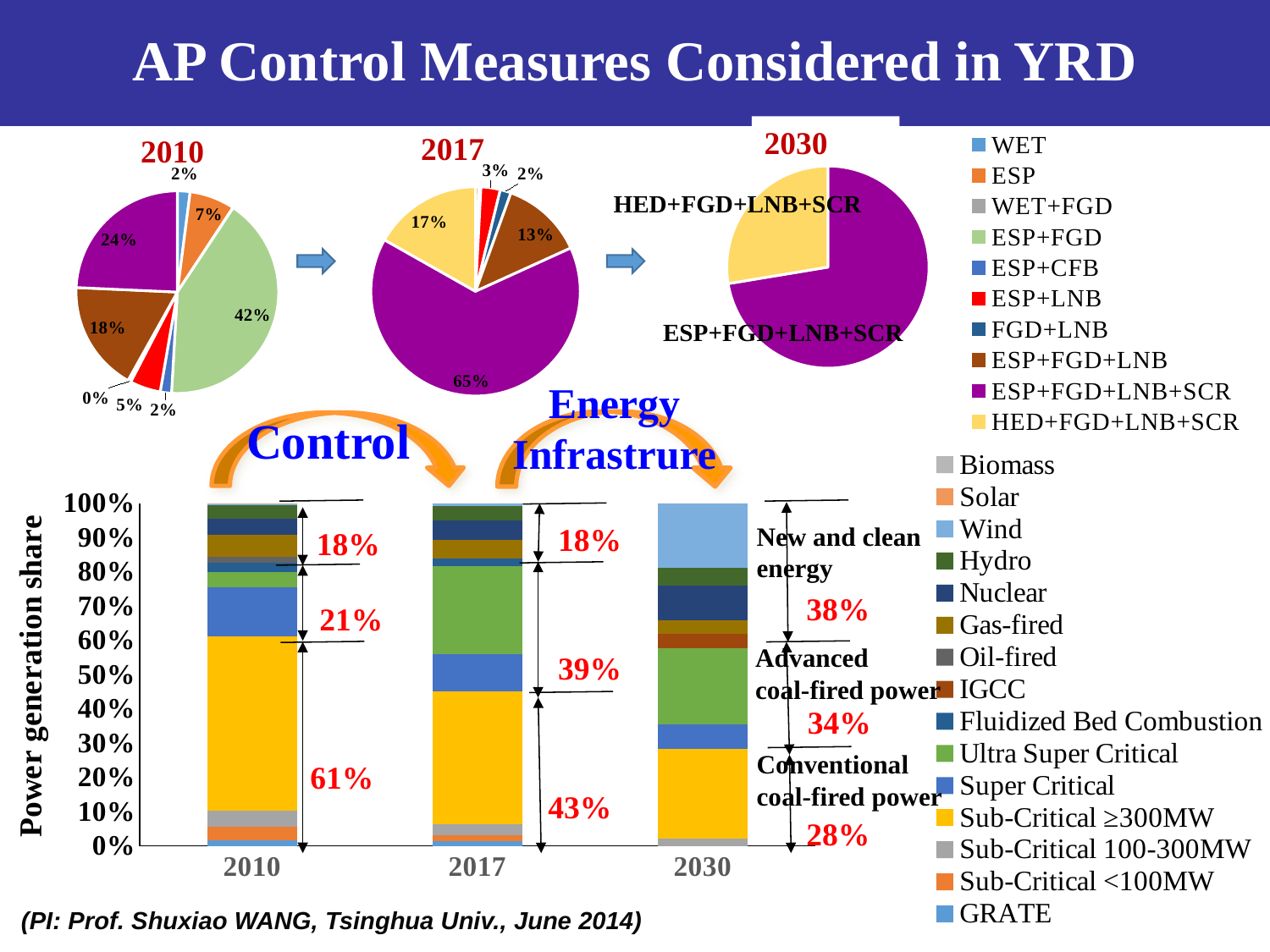
In the 2010 pie chart, what share does ESP+FGD have? 42% In the power generation share chart, what is the share of new and clean energy in 2030? 38% In the 2017 pie chart, what share does HED+FGD+LNB+SCR have? 17% In the power generation share chart, what is the share of conventional coal-fired power in 2010? 61% In the 2030 pie chart, which slice is larger, ESP+FGD+LNB+SCR or HED+FGD+LNB+SCR? ESP+FGD+LNB+SCR In the power generation share chart, does the share of conventional coal-fired power rise or fall from 2010 to 2030? fall In the 2017 pie chart, which control measure has the largest slice? ESP+FGD+LNB+SCR In the power generation share chart, by how many percentage points does the conventional coal-fired power share fall from 2010 to 2030? 33% How many entries does the legend of the power generation share chart list? 15 How many slices does the 2030 pie chart have? 2 In the power generation share chart, what is the share of advanced coal-fired power in 2017? 39% In the 2010 pie chart, what share does ESP+FGD+LNB+SCR have? 24%